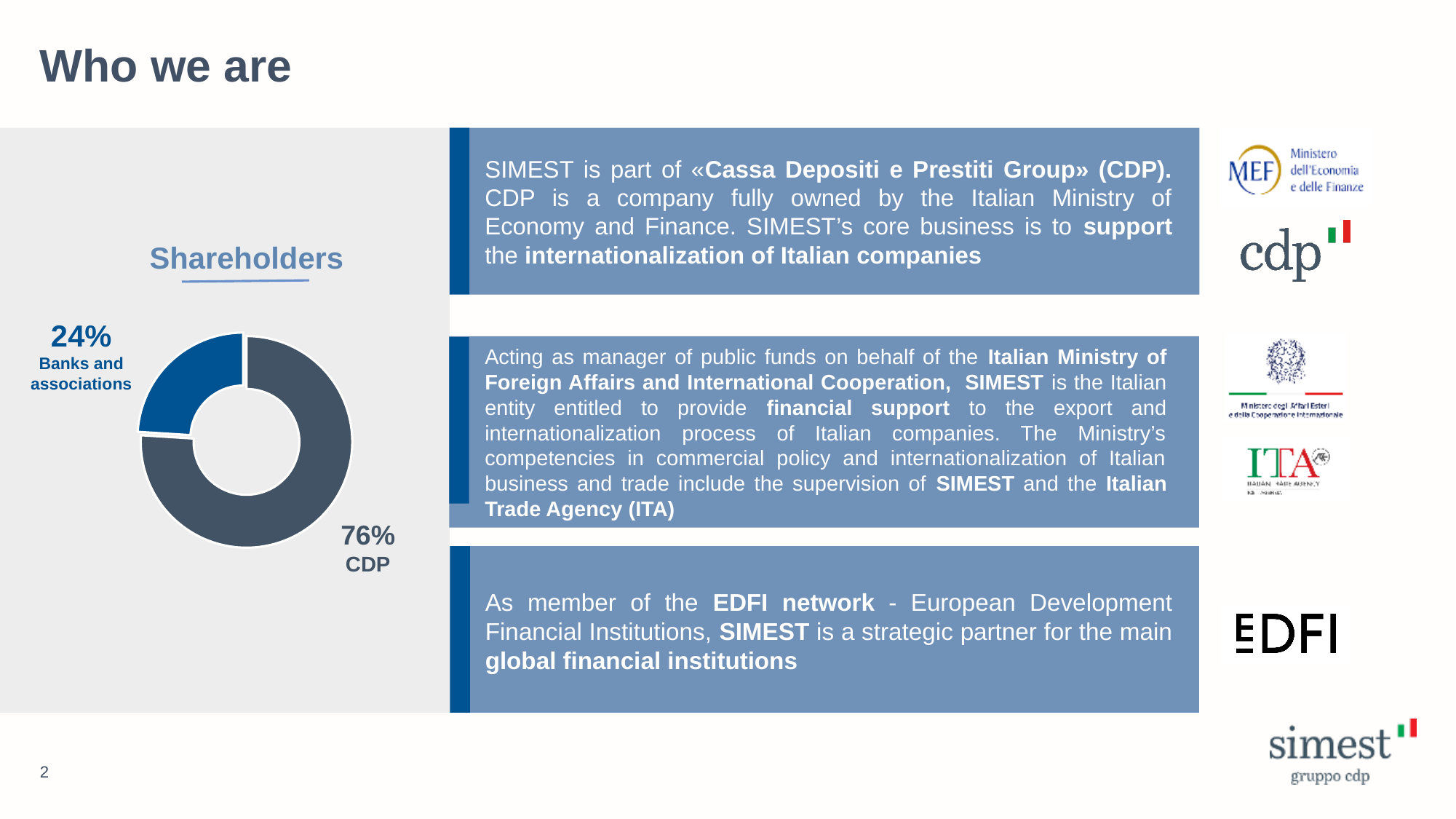
Which shareholder category has the smallest share in the Shareholders chart? Banks and associations What is the title of the chart on the left of the slide? Shareholders What kind of chart is the Shareholders chart? Pie chart (donut) Which shareholder category has the largest share in the Shareholders chart? CDP How many categories are shown in the Shareholders chart? 2 What share of shareholders does CDP hold according to the Shareholders chart? 76% What share of shareholders do Banks and associations hold according to the Shareholders chart? 24% What colour is the CDP slice in the Shareholders chart? Dark grey Which is larger in the Shareholders chart: the share of CDP or the share of Banks and associations? CDP What is the total of the two shares shown in the Shareholders chart? 100% What is the difference in percentage points between the CDP share and the Banks and associations share in the Shareholders chart? 52